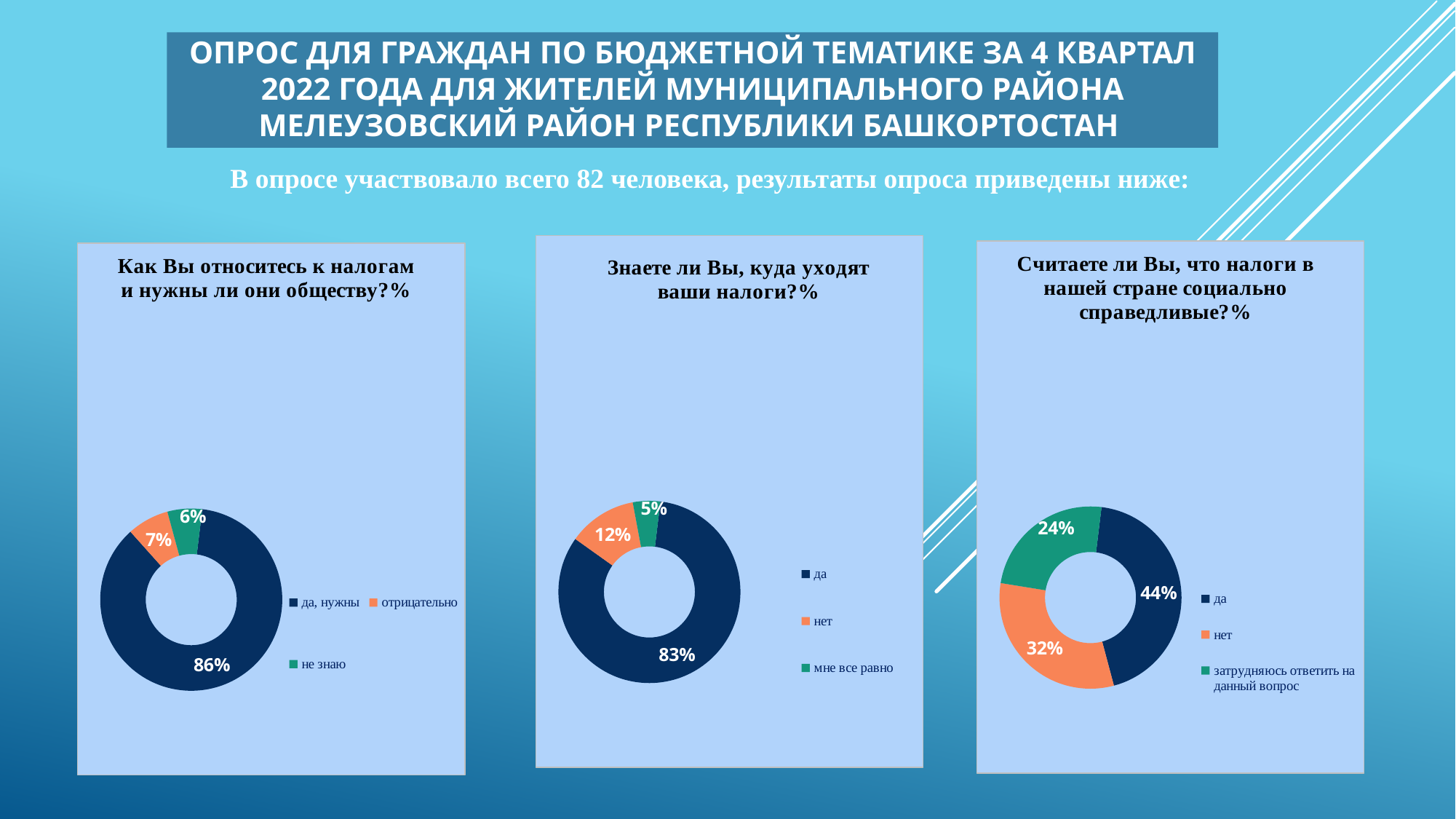
What type of chart is the middle chart ("Знаете ли Вы, куда уходят ваши налоги?%")? Doughnut chart In the right chart ("Считаете ли Вы, что налоги в нашей стране социально справедливые?%"), which is larger, "да" or "затрудняюсь ответить на данный вопрос"? да In the left chart ("Как Вы относитесь к налогам и нужны ли они обществу?%"), what is the value for "отрицательно"? 7% In the left chart ("Как Вы относитесь к налогам и нужны ли они обществу?%"), what share of respondents answered "да, нужны"? 86% In the left chart ("Как Вы относитесь к налогам и нужны ли они обществу?%"), which category has the smallest share? не знаю In the middle chart ("Знаете ли Вы, куда уходят ваши налоги?%"), what is the difference between the "да" and "нет" shares? 71% In the right chart ("Считаете ли Вы, что налоги в нашей стране социально справедливые?%"), what is the difference between "да" and "нет"? 12% How many categories does the right chart ("Считаете ли Вы, что налоги в нашей стране социально справедливые?%") show? 3 In the middle chart ("Знаете ли Вы, куда уходят ваши налоги?%"), which category has the largest share? да In the middle chart ("Знаете ли Вы, куда уходят ваши налоги?%"), what is the value for "нет"? 12% In the middle chart ("Знаете ли Вы, куда уходят ваши налоги?%"), which colour represents "мне все равно"? Green In the right chart ("Считаете ли Вы, что налоги в нашей стране социально справедливые?%"), what is the value for "нет"? 32%